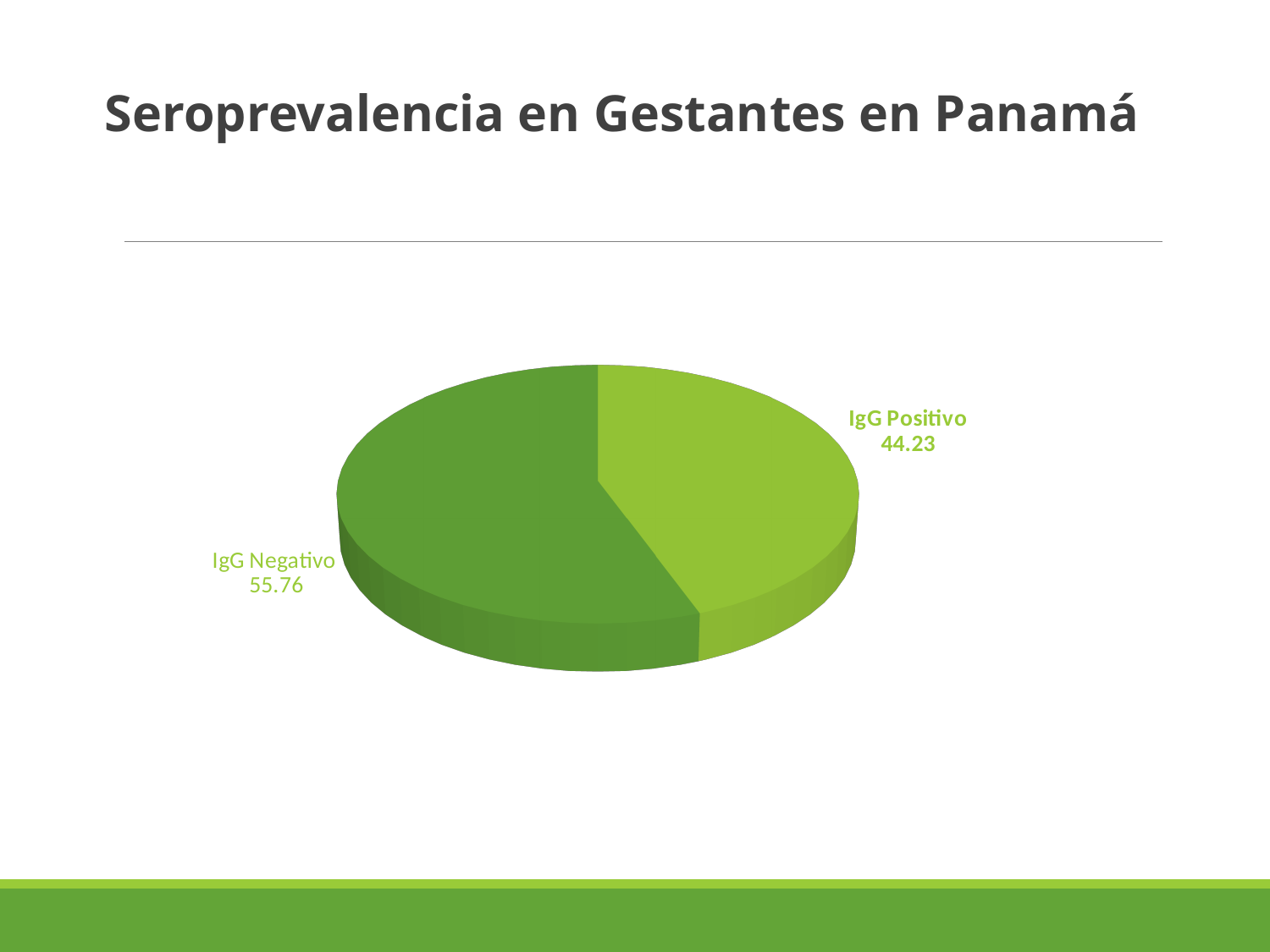
What is the value for IgG Positivo? 44.23 Is the value for IgG Positivo greater or less than 50? less How many slices does the pie chart have? 2 Which category has the smallest slice of the pie? IgG Positivo What kind of chart is shown on the slide? Pie chart Is the value for IgG Negativo greater or less than 50? greater What is the difference between the IgG Negativo and IgG Positivo values? 11.53 What is the value for IgG Negativo? 55.76 Which category has the largest slice of the pie? IgG Negativo Which is larger, IgG Positivo or IgG Negativo? IgG Negativo What is the title of the slide? Seroprevalencia en Gestantes en Panamá